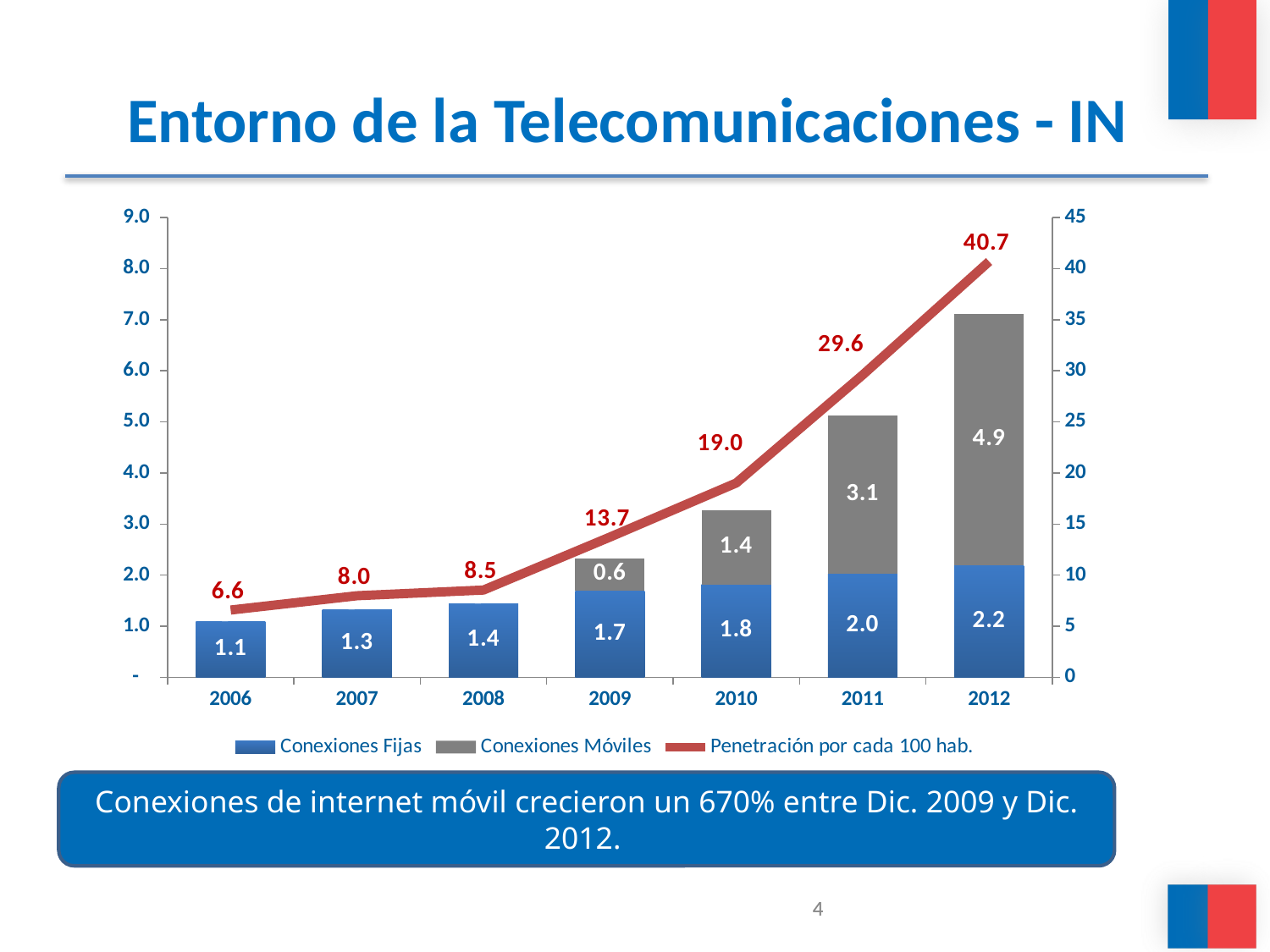
How many years are shown on the x axis? 7 What colour represents Conexiones Móviles in the chart? Grey Which is larger in 2010: Conexiones Fijas or Conexiones Móviles? Conexiones Fijas What is the Penetración por cada 100 hab. value for 2009? 13.7 How many series does the legend list? 3 What is the value of Conexiones Móviles for 2011? 3.1 What is the difference between Conexiones Móviles in 2012 and in 2009? 4.3 Does Penetración por cada 100 hab. rise or fall from 2006 to 2012? rise In which year is Penetración por cada 100 hab. highest? 2012 In which year is Conexiones Fijas lowest? 2006 What is the total of the stacked bar for 2012? 7.1 What is the value of Conexiones Fijas for 2012? 2.2